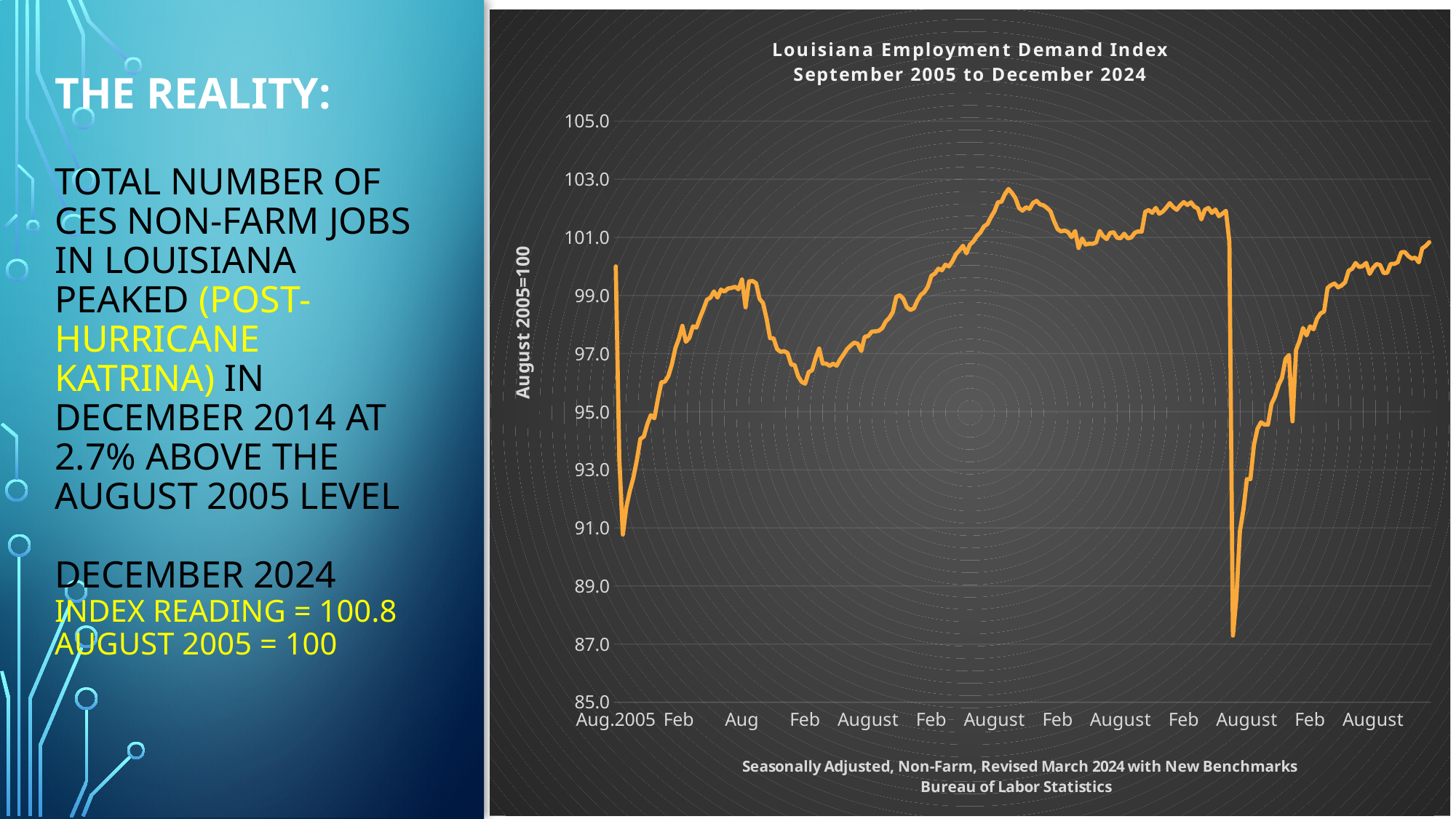
What is the highest value labelled on the vertical axis? 105.0 What kind of chart is shown on the slide? line chart Is the lowest point of the line (the deep dip near the right side of the chart) greater or less than 89.0? less What is the index reading for December 2024? 100.8 Is the highest point of the line greater or less than 101.0? greater Which dip reaches a lower value: the dip right after Aug.2005 or the deep dip near the right side of the chart? the deep dip near the right side How many tick labels are shown on the vertical axis? 11 What is the title of the chart? Louisiana Employment Demand Index September 2005 to December 2024 Is the highest point of the line greater or less than 103.0? less Does the line rise or fall from the deep dip near the right side of the chart to the end of the series? rise What is the index value for August 2005, the base period? 100 What is the label on the vertical axis of the chart? August 2005=100